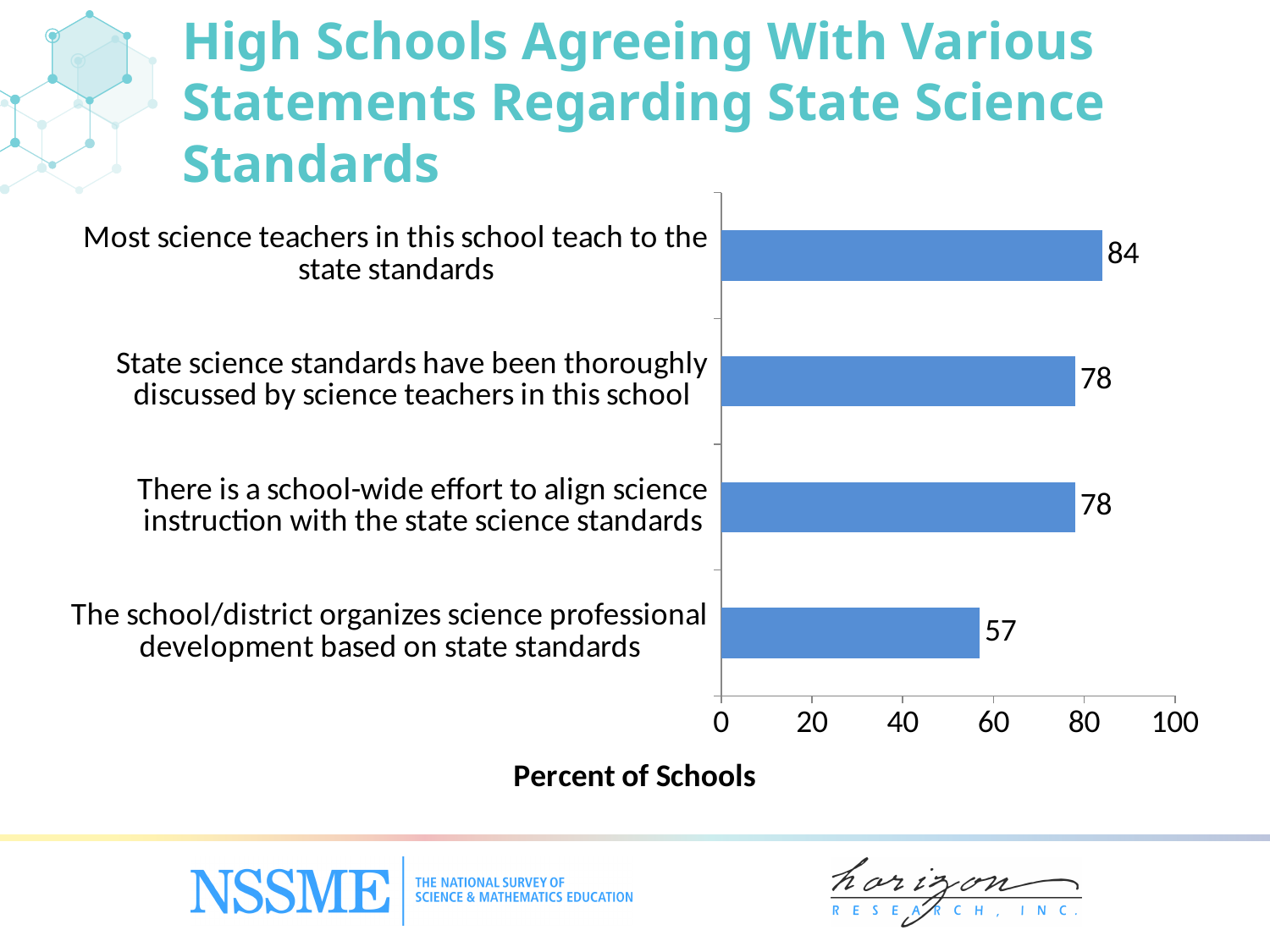
What is the value for 'There is a school-wide effort to align science instruction with the state science standards'? 78 Which statement has the highest percent of schools agreeing? Most science teachers in this school teach to the state standards Which statement has the lowest percent of schools agreeing? The school/district organizes science professional development based on state standards What is the difference between the value for 'Most science teachers in this school teach to the state standards' and the value for 'The school/district organizes science professional development based on state standards'? 27 What is the label of the horizontal axis? Percent of Schools What percent of high schools agree that most science teachers in this school teach to the state standards? 84 Which is larger: the value for 'State science standards have been thoroughly discussed by science teachers in this school' or the value for 'The school/district organizes science professional development based on state standards'? State science standards have been thoroughly discussed by science teachers in this school Is the value for 'The school/district organizes science professional development based on state standards' greater or less than 60? less How many statements are shown in the chart? 4 What kind of chart is shown on the slide? bar chart What is the value for 'The school/district organizes science professional development based on state standards'? 57 What is the difference between the value for 'Most science teachers in this school teach to the state standards' and the value for 'State science standards have been thoroughly discussed by science teachers in this school'? 6